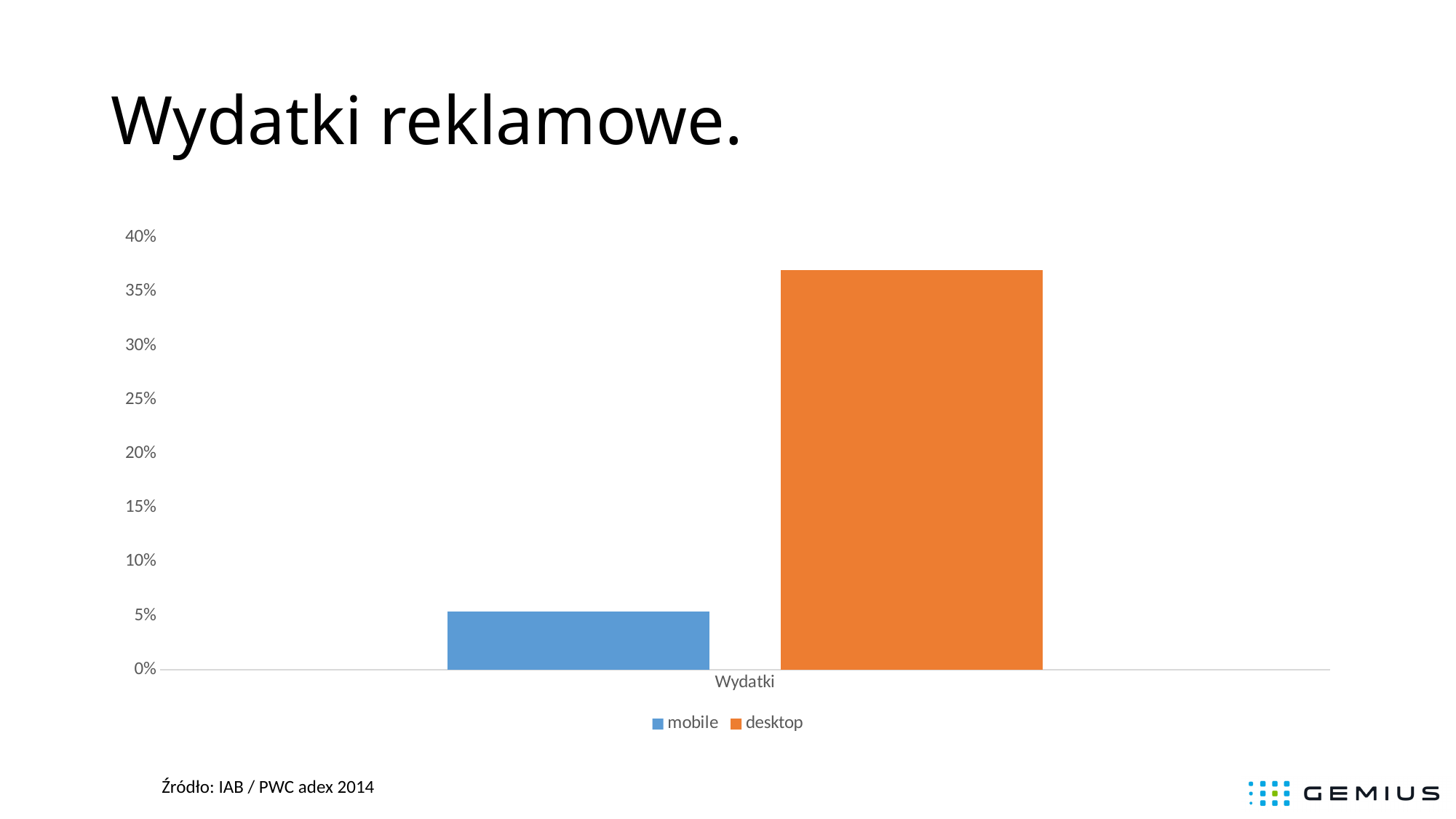
Is the value for mobile greater or less than 10%? less How many series does the legend list? 2 Which series has the higher value for Wydatki, mobile or desktop? desktop What colour is the bar for the desktop series? orange What is the label of the category on the x axis? Wydatki Which series has the highest value in the chart? desktop Which series has the lowest value in the chart? mobile How many categories are shown on the x axis? 1 Is the value for desktop greater or less than 30%? greater What is the title of the slide? Wydatki reklamowe. Is the value for desktop greater or less than 40%? less What kind of chart is shown on the slide? bar chart